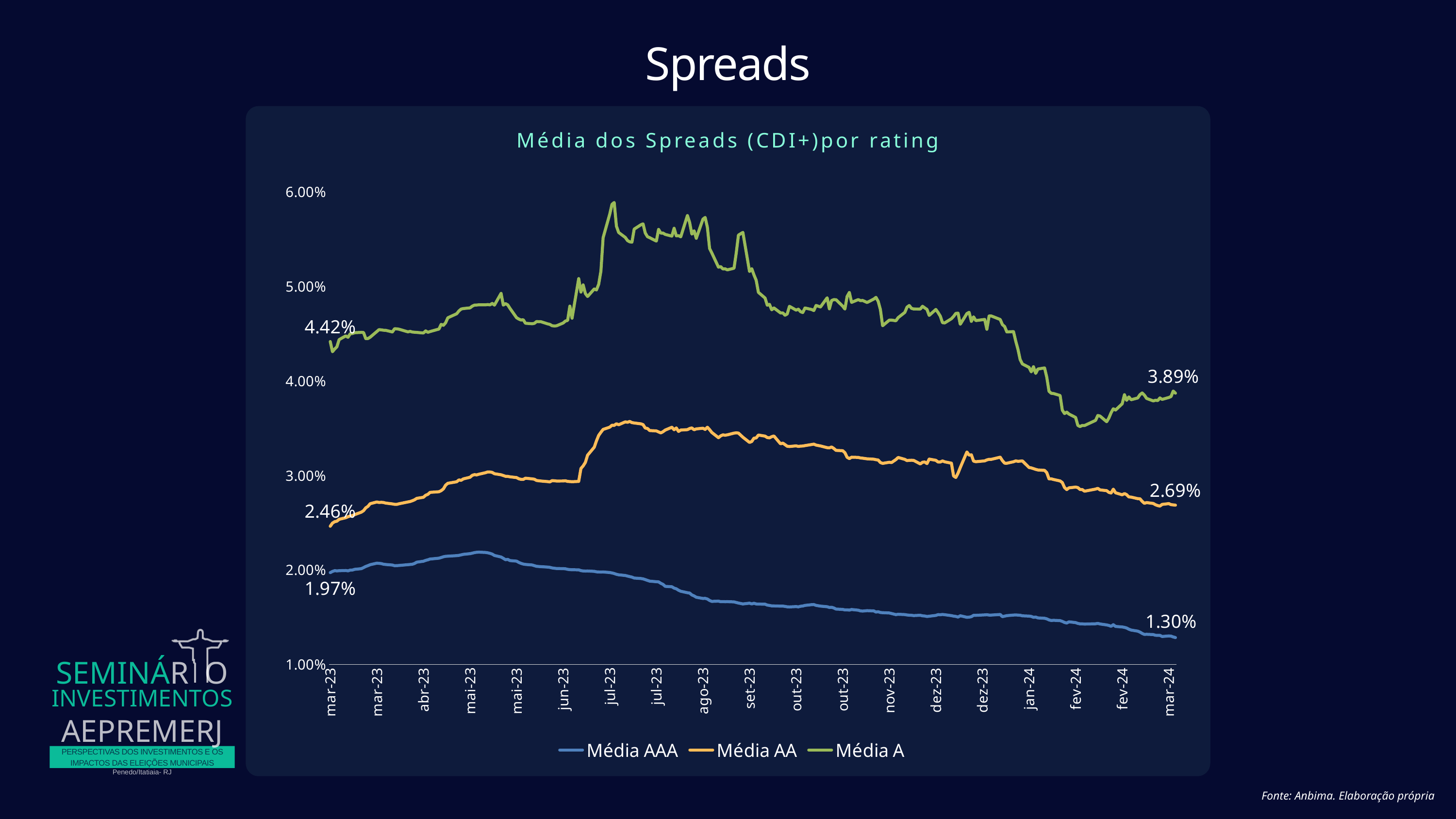
By how much did Média AAA change from its first labelled value (1.97%) to its last labelled value (1.30%)? 0.67% What kind of chart is shown on the slide? line chart What is the value of Média A at the start of the series (mar-23)? 4.42% What is the value of Média AA at the end of the series (mar-24)? 2.69% What is the value of Média AA at the start of the series (mar-23)? 2.46% Does Média AAA rise or fall overall from mar-23 to mar-24? fall What is the value of Média A at the end of the series (mar-24)? 3.89% Is the peak value of Média A around jul-23 greater or less than 5.00%? greater What is the value of Média AAA at the end of the series (mar-24)? 1.30% Which series has the highest values throughout the chart? Média A How many series does the legend list? 3 What is the title of the chart? Média dos Spreads (CDI+)por rating